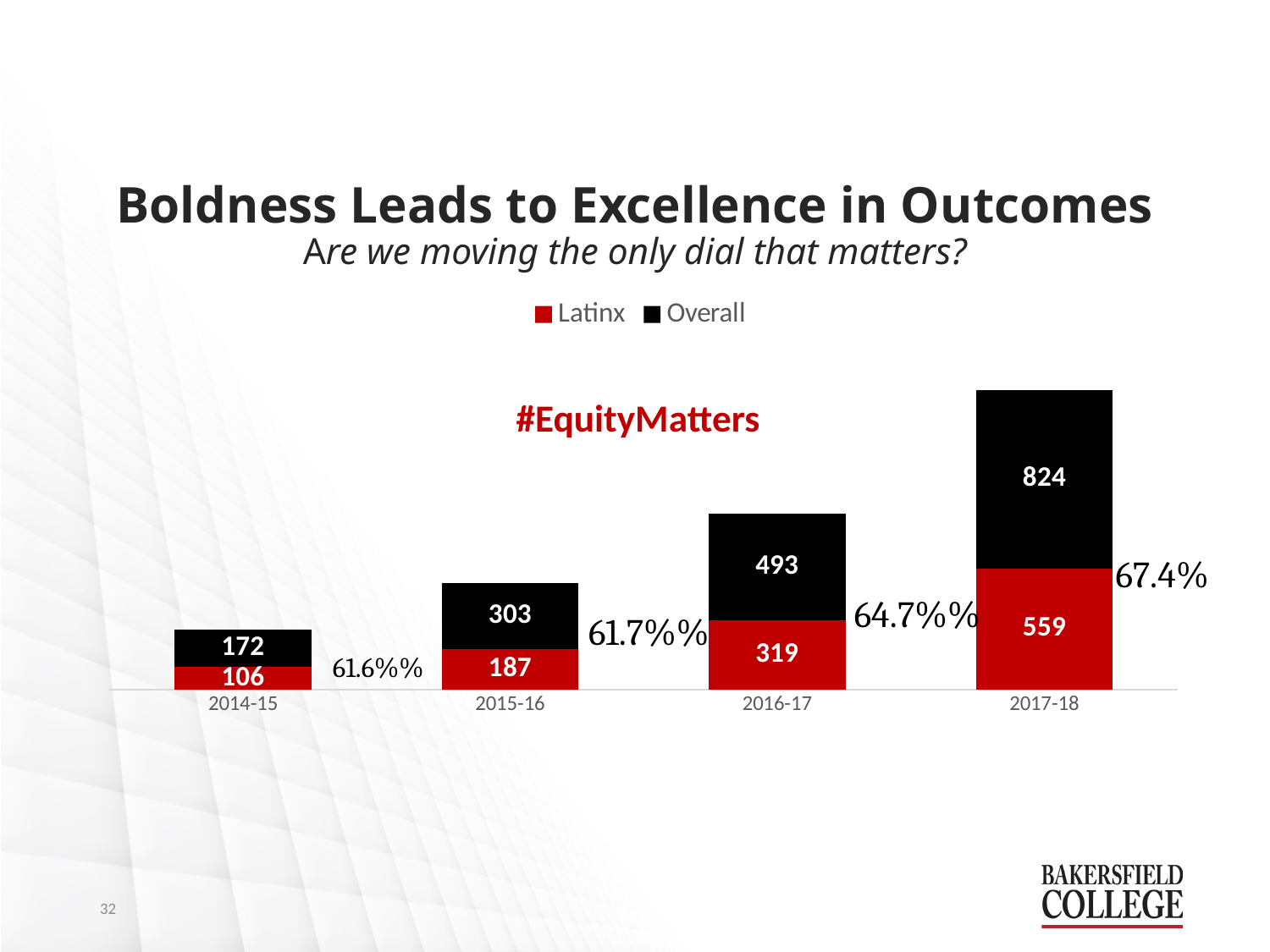
Which year has the highest Overall value? 2017-18 What is the Overall value for 2016-17? 493 Which is larger, the Latinx value for 2015-16 or the Latinx value for 2016-17? 2016-17 Do the Overall values rise or fall from 2014-15 to 2017-18? Rise What is the Latinx value for 2017-18? 559 What kind of chart is shown on the slide? Stacked bar chart What is the Overall value for 2015-16? 303 What is the difference between the Overall value and the Latinx value in 2016-17? 174 How many years are shown on the x axis? 4 How many series does the legend list? 2 What is the Latinx value for 2014-15? 106 Which year has the lowest Latinx value? 2014-15